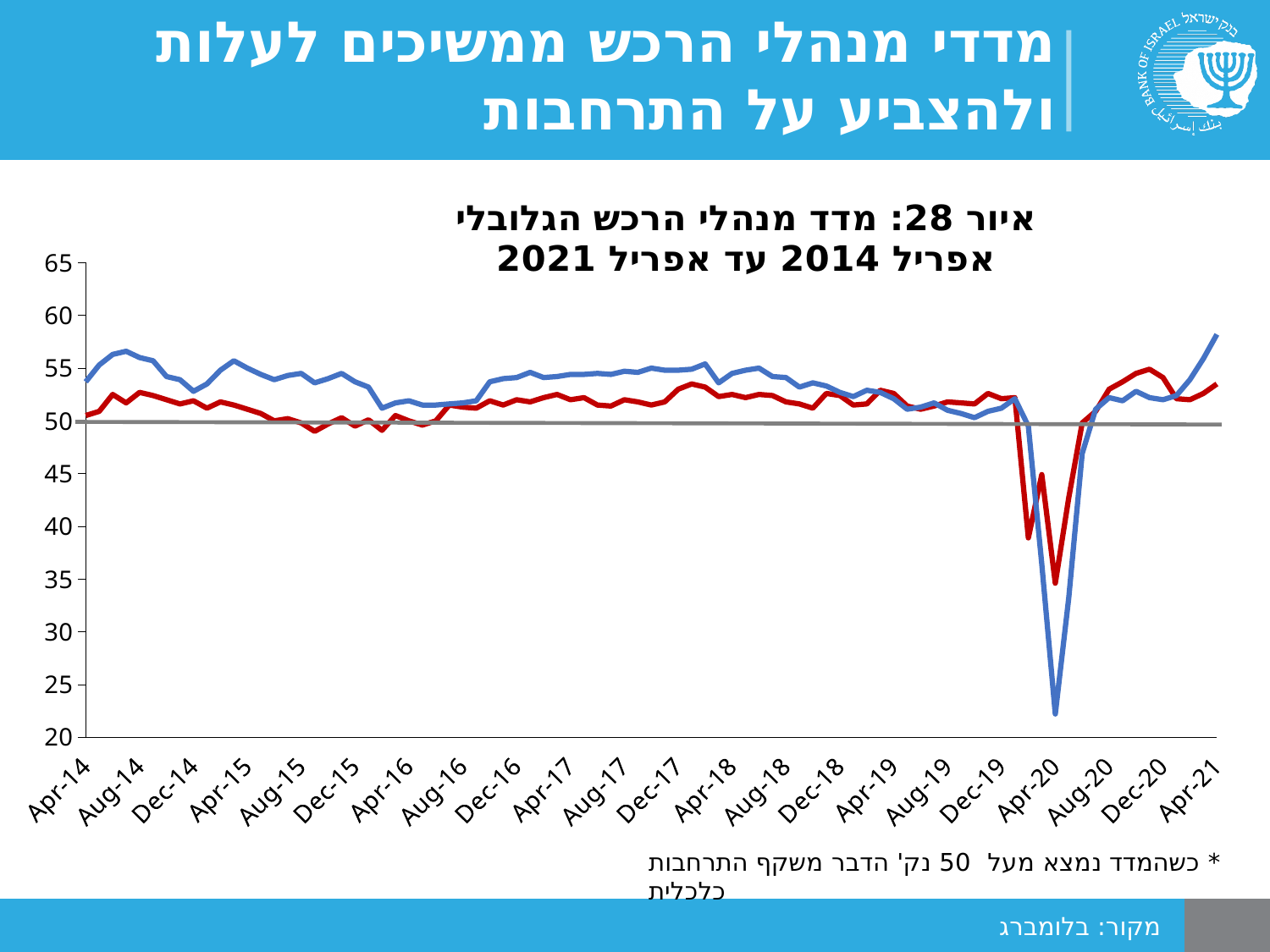
At what value is the grey horizontal reference line drawn? 50 Is the value of the blue line at Apr-21 greater or less than 55? greater What is the figure number given in the chart title? 28 How many coloured data lines (excluding the grey reference line) are plotted on the chart? 2 What is the highest value shown on the y axis? 65 What source is cited at the bottom of the slide? בלומברג At Apr-20, which line has the lower value, the blue line or the red line? blue line How many date labels are shown along the x axis? 22 Is the value of the red line at Apr-20 greater or less than 40? less Around which x-axis label does the blue line reach its lowest point? Apr-20 Is the value of the blue line at Apr-20 greater or less than 30? less What kind of chart is shown on the slide? line chart